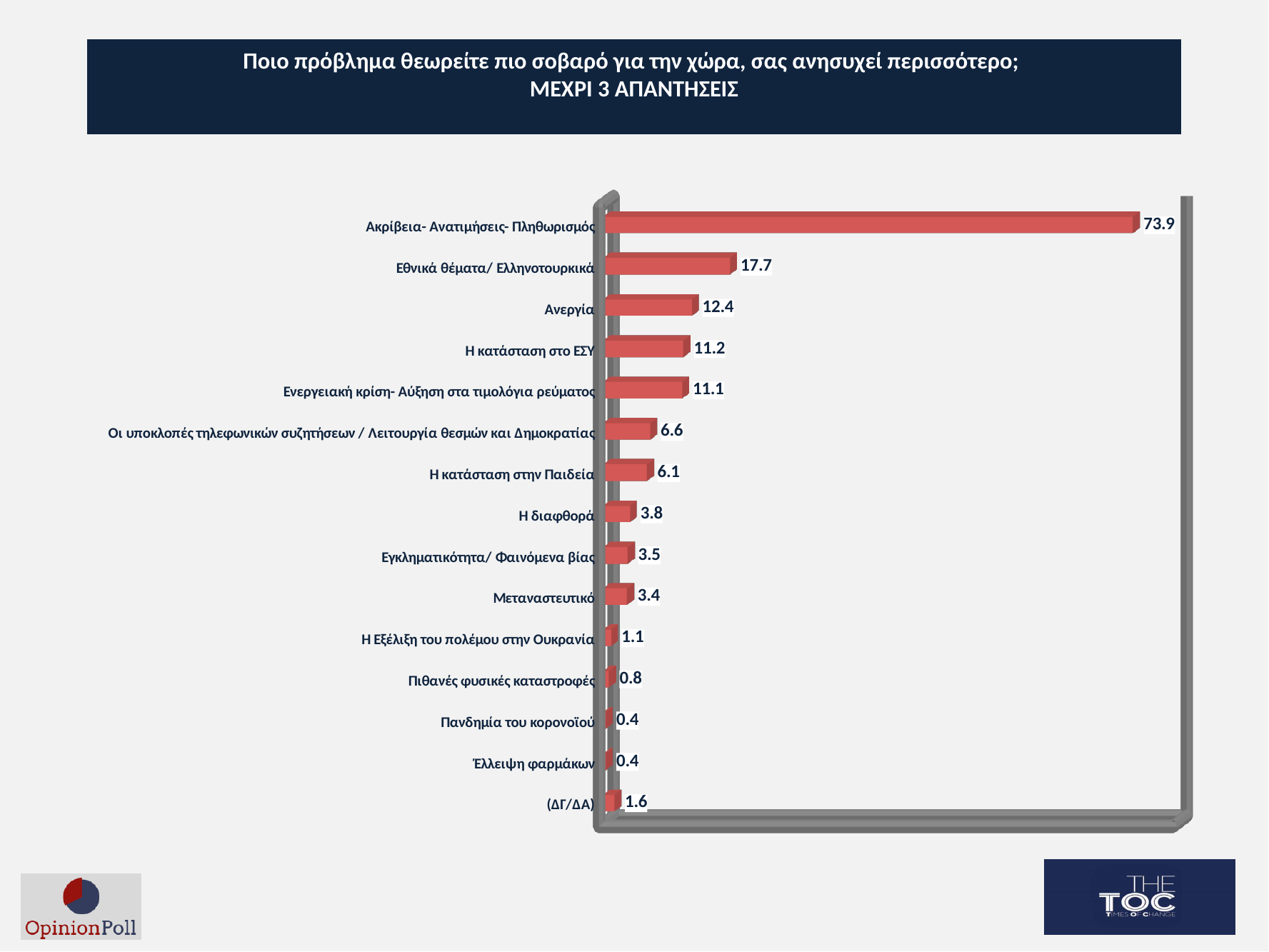
Which has a larger value, Η διαφθορά or Εγκληματικότητα/ Φαινόμενα βίας? Η διαφθορά Which has a larger value, Η Εξέλιξη του πολέμου στην Ουκρανία or Πιθανές φυσικές καταστροφές? Η Εξέλιξη του πολέμου στην Ουκρανία What value is shown for Η κατάσταση στο ΕΣΥ? 11.2 What is the difference between the values for Ακρίβεια- Ανατιμήσεις- Πληθωρισμός and Εθνικά θέματα/ Ελληνοτουρκικά? 56.2 What is the difference between the values for Ανεργία and Η κατάσταση στο ΕΣΥ? 1.2 What value is shown for Ακρίβεια- Ανατιμήσεις- Πληθωρισμός? 73.9 What kind of chart is shown on the slide? Bar chart What value is shown for Εθνικά θέματα/ Ελληνοτουρκικά? 17.7 What value is shown for (ΔΓ/ΔΑ)? 1.6 Which category has the highest value? Ακρίβεια- Ανατιμήσεις- Πληθωρισμός How many categories are shown in the chart? 15 What value is shown for Μεταναστευτικό? 3.4